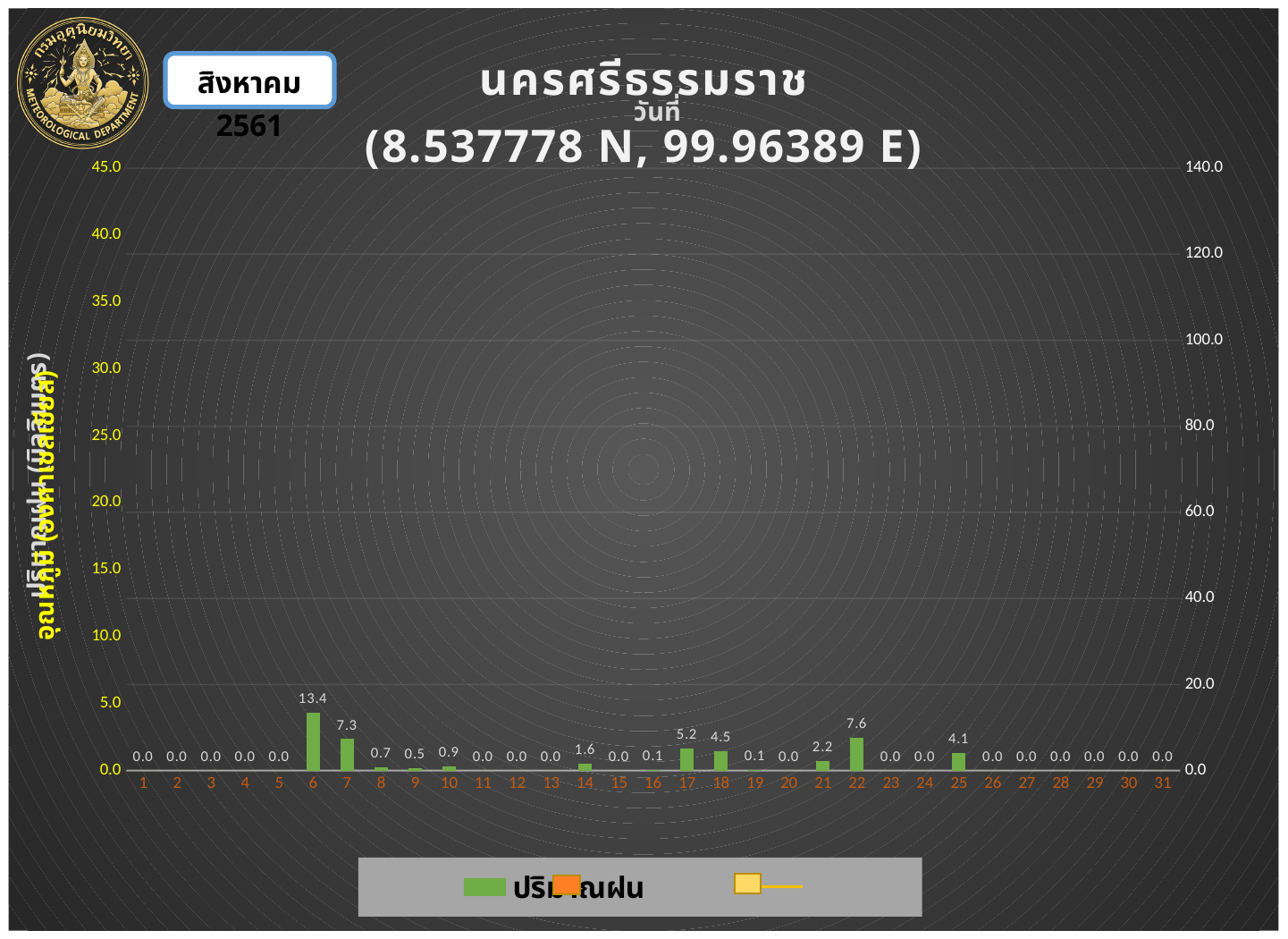
What is the value for day 6? 13.4 What kind of chart is this? bar chart What is the value for day 22? 7.6 What is the value for day 25? 4.1 What is the value for day 14? 1.6 What coordinates are shown in the chart title? 8.537778 N, 99.96389 E What is the difference between the values for day 6 and day 7? 6.1 What is the value for day 17? 5.2 Which day has the highest value? 6 Which is larger, the value for day 7 or the value for day 22? day 22 How many days are shown on the x axis? 31 What is the difference between the values for day 17 and day 18? 0.7